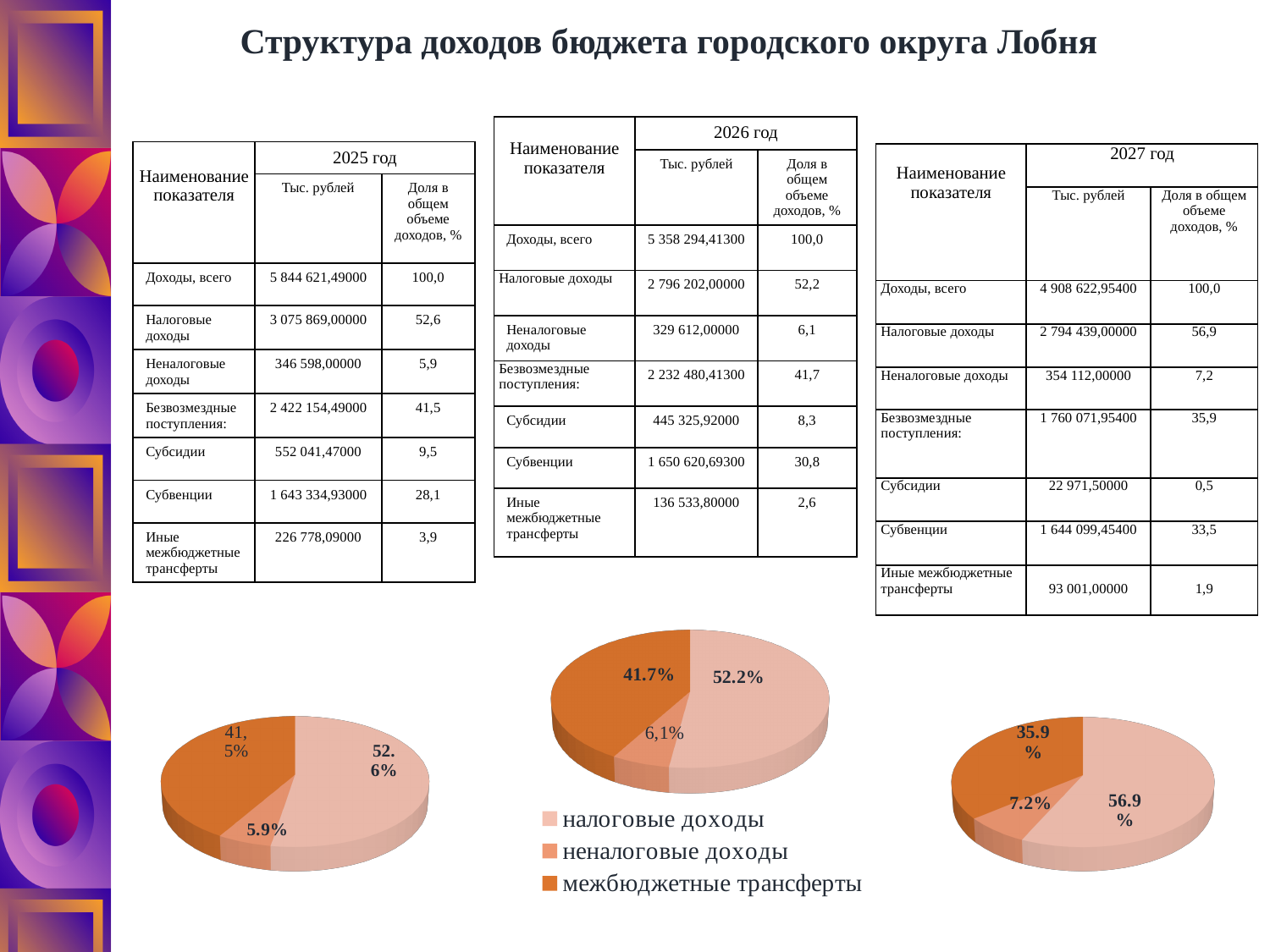
In the right pie chart, which category has the smallest slice? неналоговые доходы In the middle pie chart, what share is labelled for неналоговые доходы? 6,1% What kind of charts are shown at the bottom of the slide? pie charts In the middle pie chart, what share is labelled for межбюджетные трансферты? 41.7% How many entries does the legend under the middle pie chart list? 3 In the left pie chart, what share is labelled for неналоговые доходы? 5.9% In the left pie chart, what share is labelled for the largest slice (налоговые доходы)? 52.6% In the right pie chart, what share is labelled for налоговые доходы? 56.9% In the right pie chart, which slice is larger: налоговые доходы or межбюджетные трансферты? налоговые доходы In the middle pie chart, which category has the largest slice? налоговые доходы In the right pie chart, what is the difference between the shares for налоговые доходы (56.9%) and межбюджетные трансферты (35.9%)? 21.0% How many pie charts are on the slide? 3